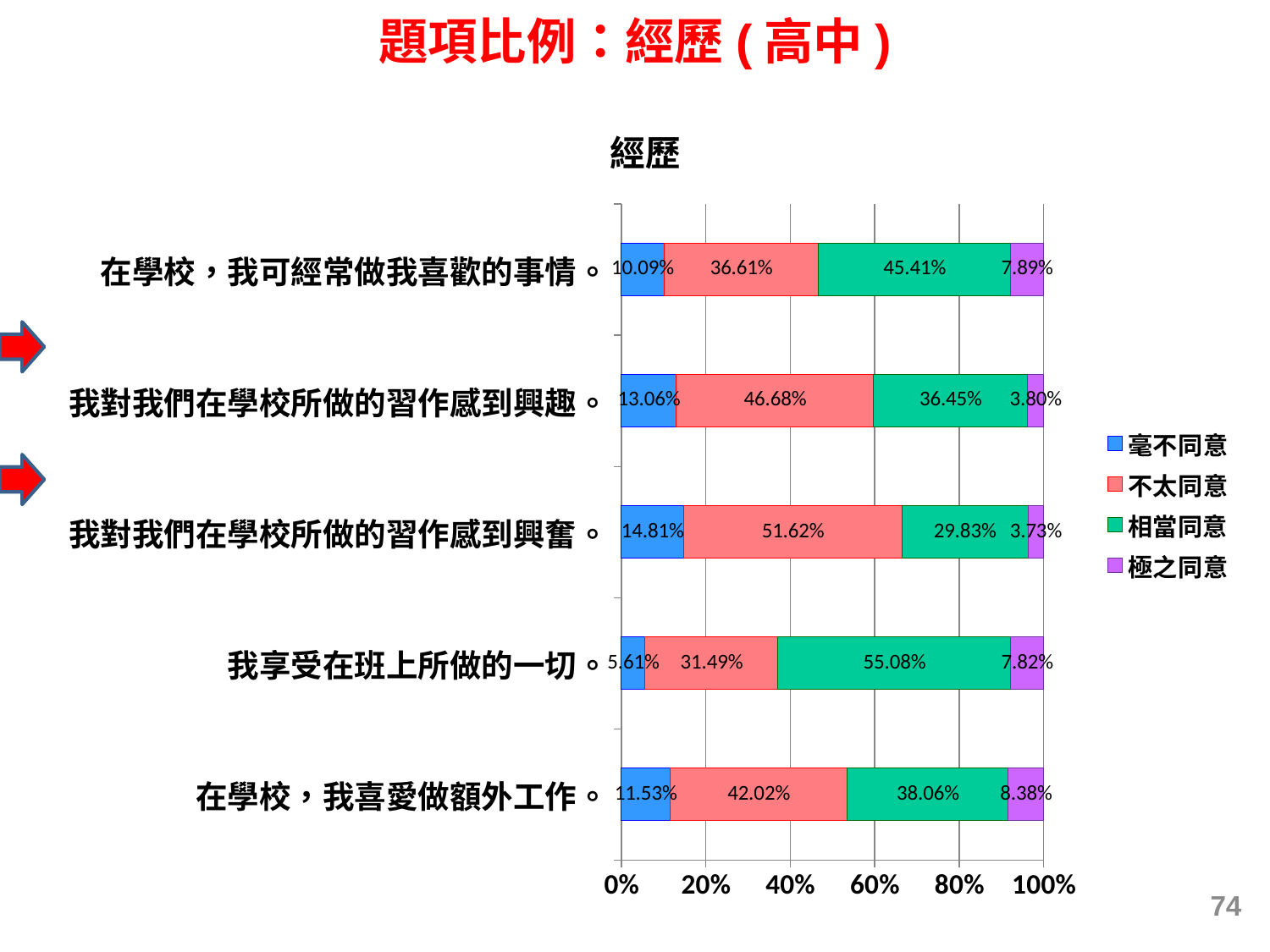
In the 經歷 chart, what is the 相當同意 value for 我享受在班上所做的一切。? 55.08% In the 經歷 chart, which item has the lowest 毫不同意 value? 我享受在班上所做的一切。 How many items (categories) are shown in the 經歷 chart? 5 How many series does the legend of the 經歷 chart list? 4 In the 經歷 chart, what is the difference in 相當同意 between 我享受在班上所做的一切。 and 在學校，我可經常做我喜歡的事情。? 9.67 percentage points In the 經歷 chart, what is the total of the four segments for 在學校，我可經常做我喜歡的事情。? 100.00% In the 經歷 chart, which has the larger 極之同意 value: 在學校，我喜愛做額外工作。 or 在學校，我可經常做我喜歡的事情。? 在學校，我喜愛做額外工作。 What kind of chart is shown on the slide? Stacked bar chart In the 經歷 chart, which item has the highest 不太同意 value? 我對我們在學校所做的習作感到興奮。 In the 經歷 chart, what is the 毫不同意 value for 我對我們在學校所做的習作感到興奮。? 14.81% In the 經歷 chart, what is the 極之同意 value for 我對我們在學校所做的習作感到興趣。? 3.80% What colour represents 相當同意 in the 經歷 chart? Green